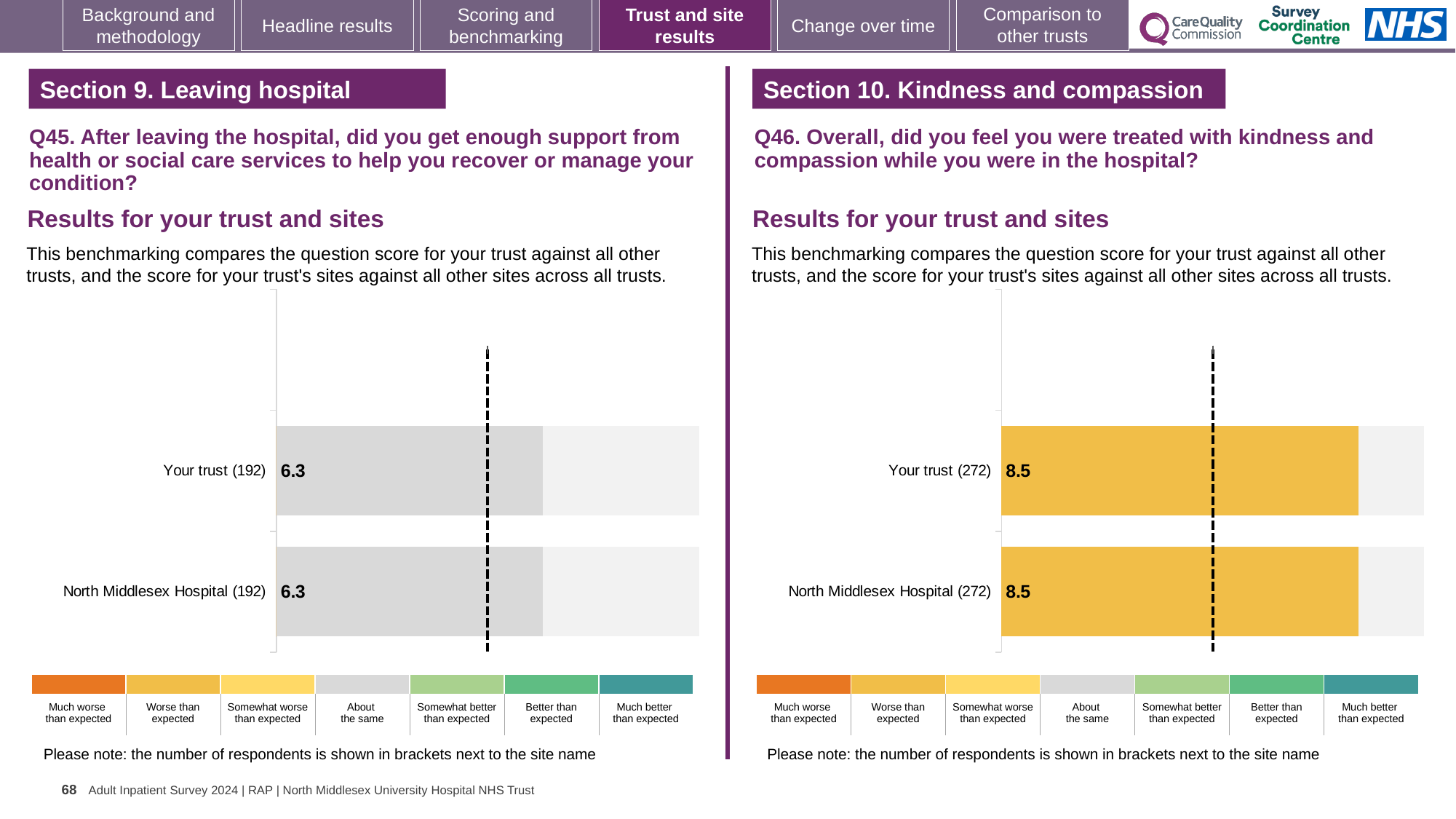
On the Q46 chart (right), what is the score for Your trust? 8.5 According to the colour key, which benchmark category do the bars on the Q45 chart (left) fall into? About the same On the Q46 chart (right), what is the difference between the score for Your trust and the score for North Middlesex Hospital? 0.0 How many respondents are shown in brackets for North Middlesex Hospital on the Q45 chart (left)? 192 On the Q45 chart (left), what is the score for North Middlesex Hospital? 6.3 On the Q46 chart (right), what is the score for North Middlesex Hospital? 8.5 How many bars are plotted on the Q46 chart (right)? 2 What kind of chart is used for the Q46 results (right)? Bar chart On the Q45 chart (left), what is the difference between the score for Your trust and the score for North Middlesex Hospital? 0.0 How many respondents are shown in brackets for Your trust on the Q46 chart (right)? 272 How many bars are plotted on the Q45 chart (left)? 2 On the Q45 chart (left), what is the score for Your trust? 6.3